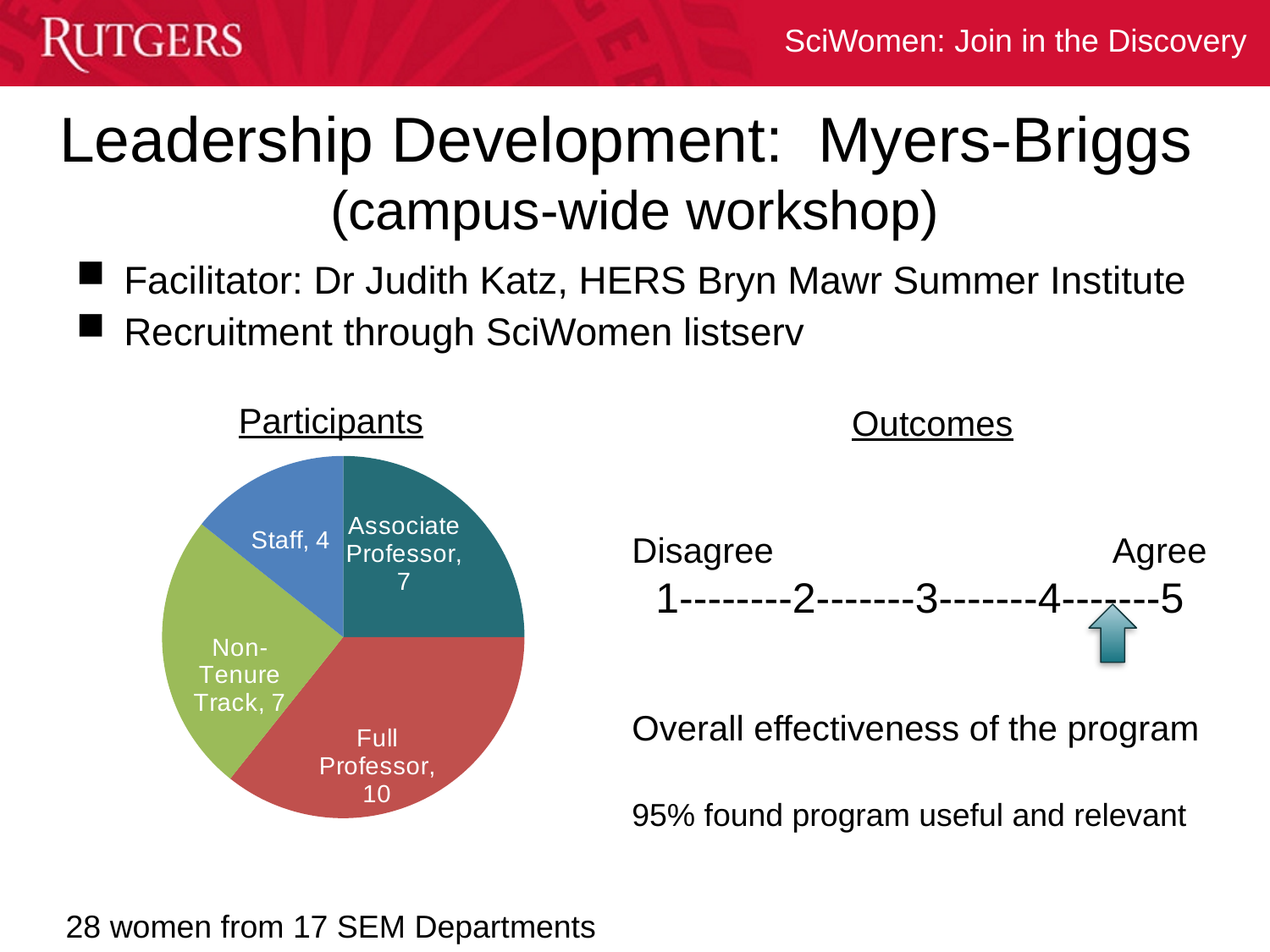
In the Participants pie chart, how many participants are Staff? 4 How many categories does the Participants pie chart show? 4 In the Participants pie chart, which is larger: Full Professor or Associate Professor? Full Professor What colour is the Full Professor slice in the Participants pie chart? red What kind of chart is the Participants chart? pie chart Which category has the smallest slice in the Participants pie chart? Staff What is the total number of participants across all slices of the Participants pie chart? 28 In the Participants pie chart, how many participants are Non-Tenure Track? 7 In the Participants pie chart, how many participants are Associate Professors? 7 In the Participants pie chart, how many more Full Professors than Staff participated? 6 Which category has the largest slice in the Participants pie chart? Full Professor In the Participants pie chart, how many participants are Full Professors? 10